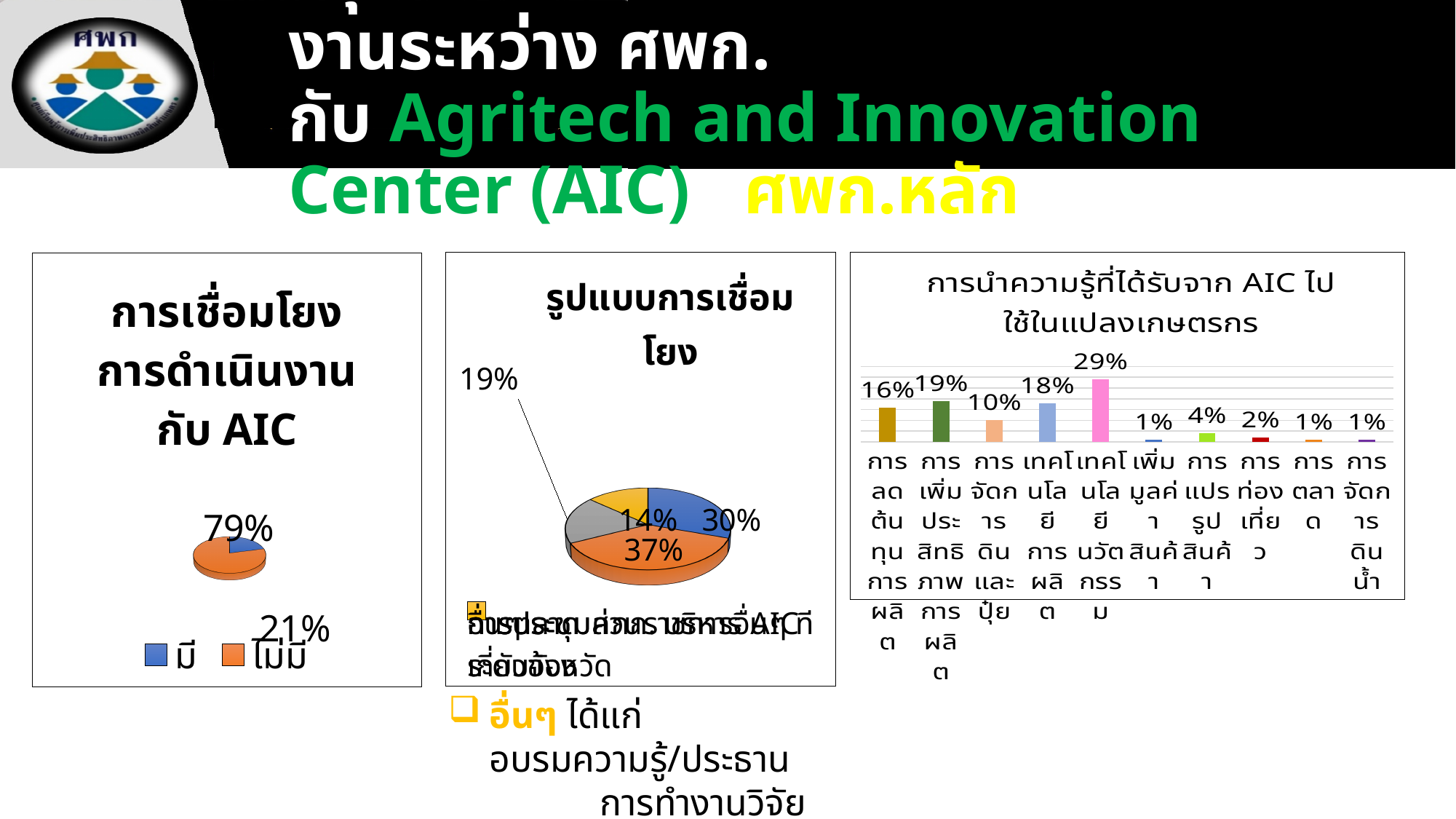
In the right chart 'การนำความรู้ที่ได้รับจาก AIC ไปใช้ในแปลงเกษตรกร', which is larger: 'การจัดการดินและปุ๋ย' or 'การแปรรูปสินค้า'? การจัดการดินและปุ๋ย In the right chart 'การนำความรู้ที่ได้รับจาก AIC ไปใช้ในแปลงเกษตรกร', what is the difference between 'เทคโนโลยีนวัตกรรม' and 'การลดต้นทุนการผลิต'? 13% In the middle pie chart 'รูปแบบการเชื่อมโยง', what is the smallest percentage shown? 14% In the middle pie chart 'รูปแบบการเชื่อมโยง', what is the largest percentage shown? 37% In the right chart 'การนำความรู้ที่ได้รับจาก AIC ไปใช้ในแปลงเกษตรกร', how many categories are plotted? 10 In the left pie chart 'การเชื่อมโยงการดำเนินงานกับ AIC', what percentage is shown for 'มี'? 21% In the left pie chart 'การเชื่อมโยงการดำเนินงานกับ AIC', what percentage is shown for 'ไม่มี'? 79% In the left pie chart 'การเชื่อมโยงการดำเนินงานกับ AIC', how many entries does the legend list? 2 In the right chart 'การนำความรู้ที่ได้รับจาก AIC ไปใช้ในแปลงเกษตรกร', which category has the highest value? เทคโนโลยีนวัตกรรม In the right chart 'การนำความรู้ที่ได้รับจาก AIC ไปใช้ในแปลงเกษตรกร', what is the value for 'การเพิ่มประสิทธิภาพการผลิต'? 19% In the middle pie chart 'รูปแบบการเชื่อมโยง', how many slices does the pie have? 4 What kind of chart is the right chart 'การนำความรู้ที่ได้รับจาก AIC ไปใช้ในแปลงเกษตรกร'? bar chart